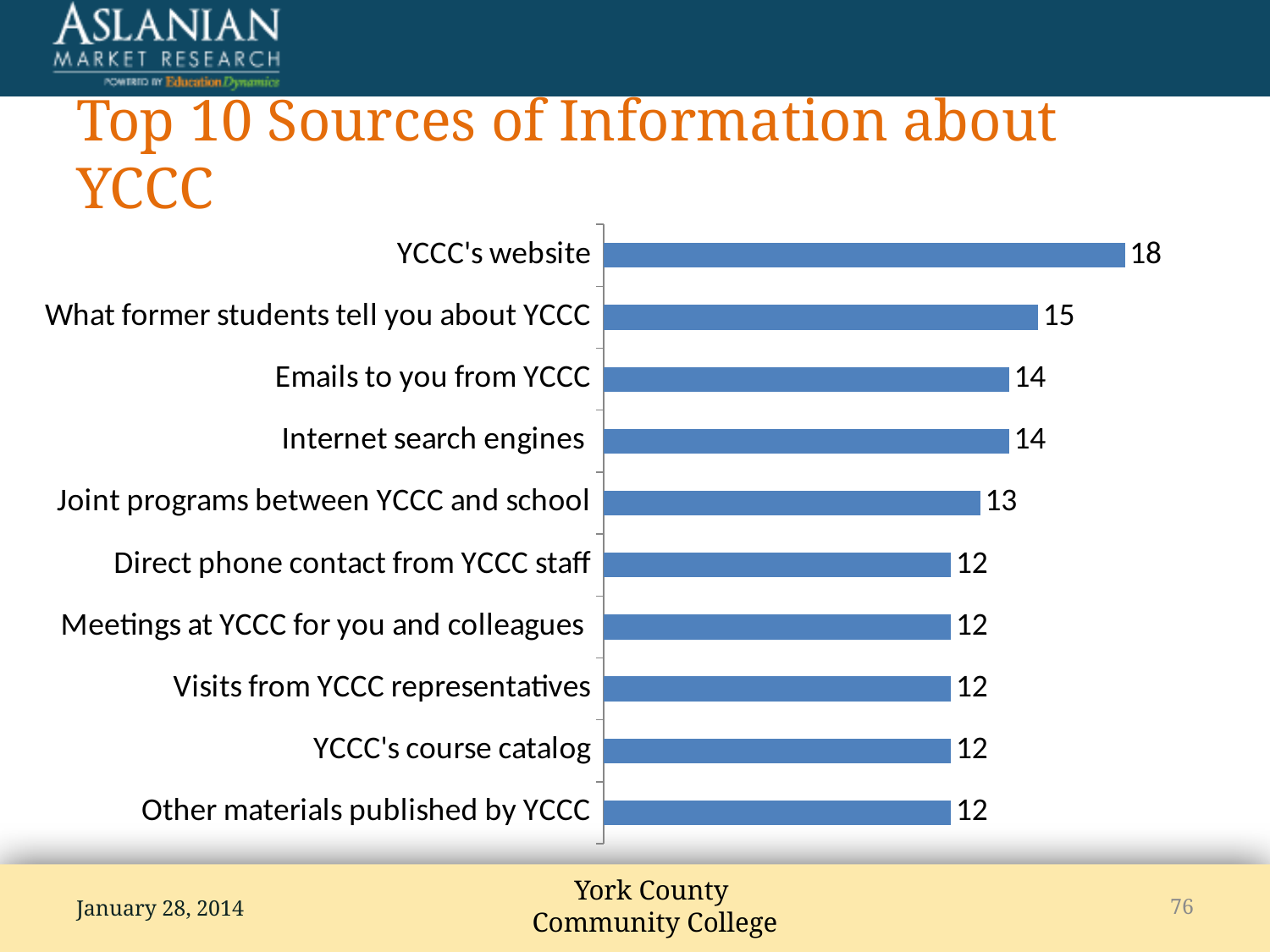
What kind of chart is shown on the slide? Bar chart What is the difference between the values for Emails to you from YCCC and Other materials published by YCCC? 2 What is the difference between the values for YCCC's website and What former students tell you about YCCC? 3 What is the title of the slide? Top 10 Sources of Information about YCCC Which is larger, the value for Joint programs between YCCC and school or the value for Direct phone contact from YCCC staff? Joint programs between YCCC and school What is the value for Internet search engines? 14 How many sources are shown in the chart? 10 What is the value for YCCC's website? 18 What is the value for Joint programs between YCCC and school? 13 How many sources have a value of 12? 5 What is the value for What former students tell you about YCCC? 15 Which source has the highest value? YCCC's website